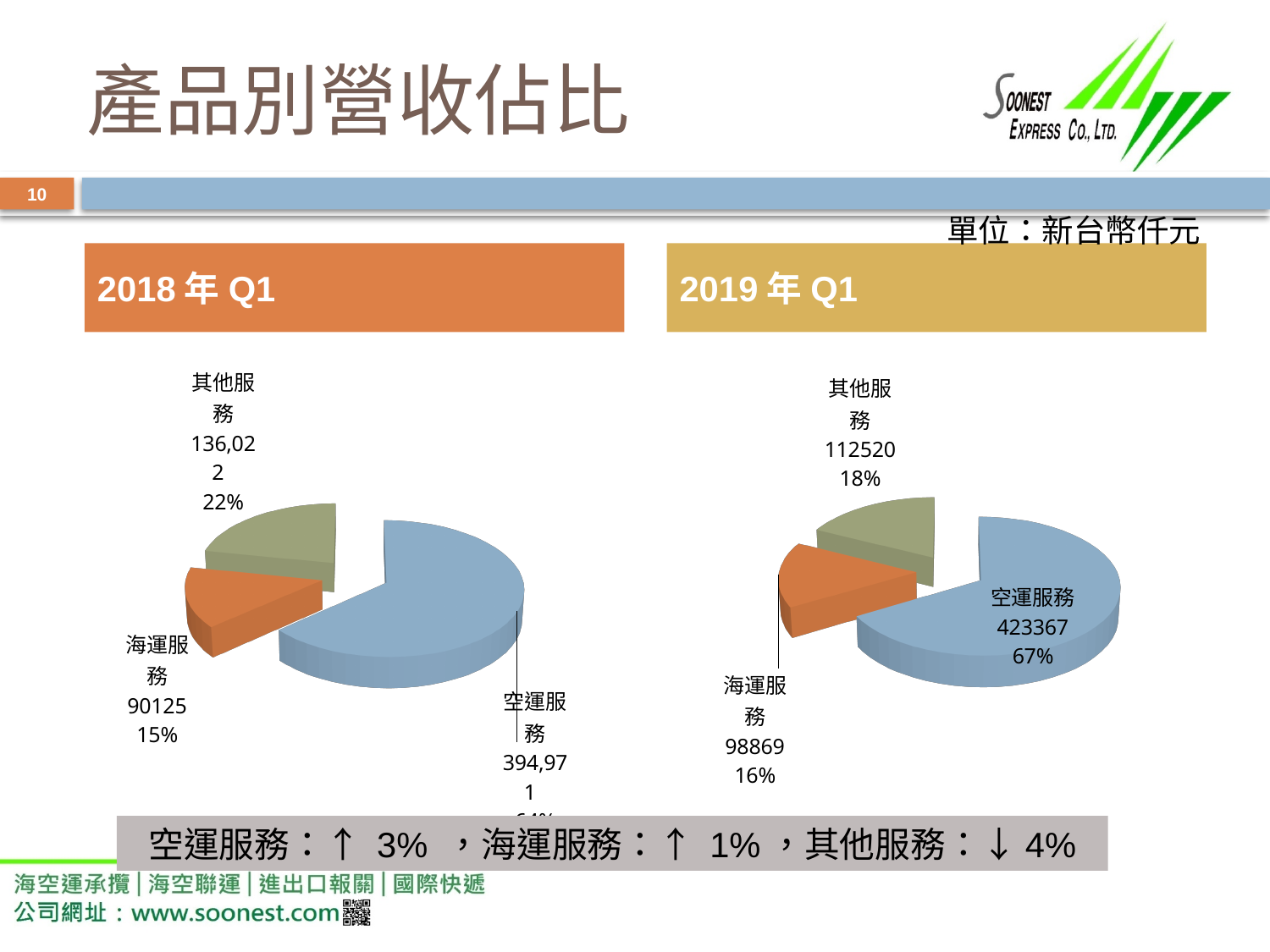
In the 2019 年 Q1 chart, what share of the pie is 空運服務? 67% In the 2018 年 Q1 chart, which category has the largest slice? 空運服務 In the 2019 年 Q1 chart, which category has the smallest slice? 海運服務 In the 2019 年 Q1 chart, what is the difference between the values for 其他服務 and 海運服務? 13651 How many slices does the 2019 年 Q1 pie chart have? 3 What kind of chart is used for 2018 年 Q1 and 2019 年 Q1? Pie chart In the 2018 年 Q1 chart, what is the value for 海運服務? 90125 In the 2019 年 Q1 chart, what share of the pie is 其他服務? 18% In the 2019 年 Q1 chart, what is the value for 海運服務? 98869 In the 2019 年 Q1 chart, what is the value for 空運服務? 423367 In the 2018 年 Q1 chart, what share of the pie is 其他服務? 22% In the 2018 年 Q1 chart, which category has the smallest slice? 海運服務